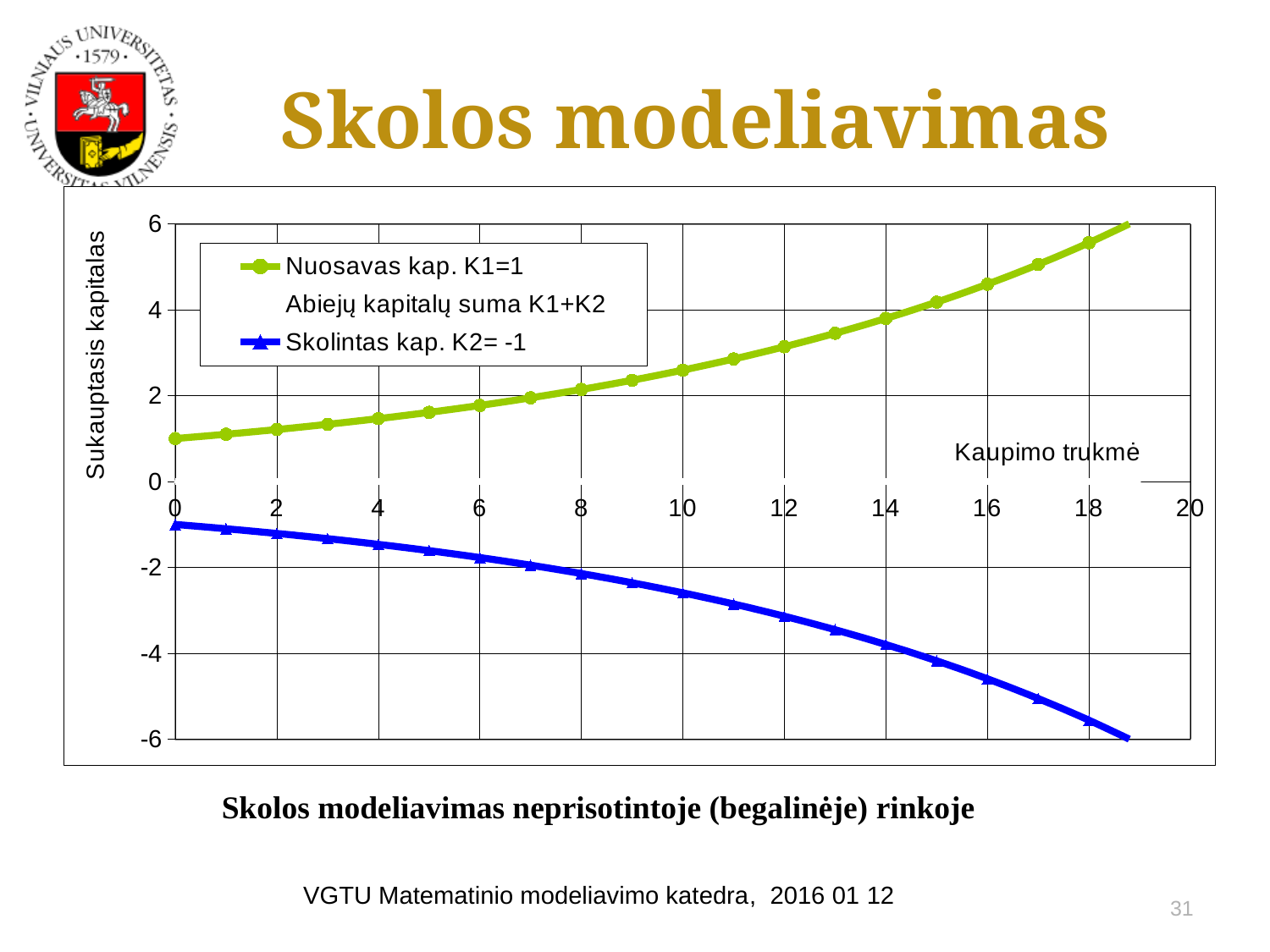
Is the value of "Skolintas kap. K2= -1" at Kaupimo trukmė 10 greater or less than -2? less At Kaupimo trukmė 12, which series has the larger value: "Nuosavas kap. K1=1" or "Skolintas kap. K2= -1"? Nuosavas kap. K1=1 What is the title of the vertical axis? Sukauptasis kapitalas Does the value of the series "Nuosavas kap. K1=1" rise or fall as Kaupimo trukmė increases? rise What kind of chart is shown on the slide? line chart Is the value of "Nuosavas kap. K1=1" at Kaupimo trukmė 4 greater or less than 2? less Is the value of "Nuosavas kap. K1=1" at Kaupimo trukmė 10 greater or less than 2? greater Does the value of the series "Skolintas kap. K2= -1" rise or fall as Kaupimo trukmė increases? fall Which series is drawn with triangle markers? Skolintas kap. K2= -1 How many series does the legend list? 3